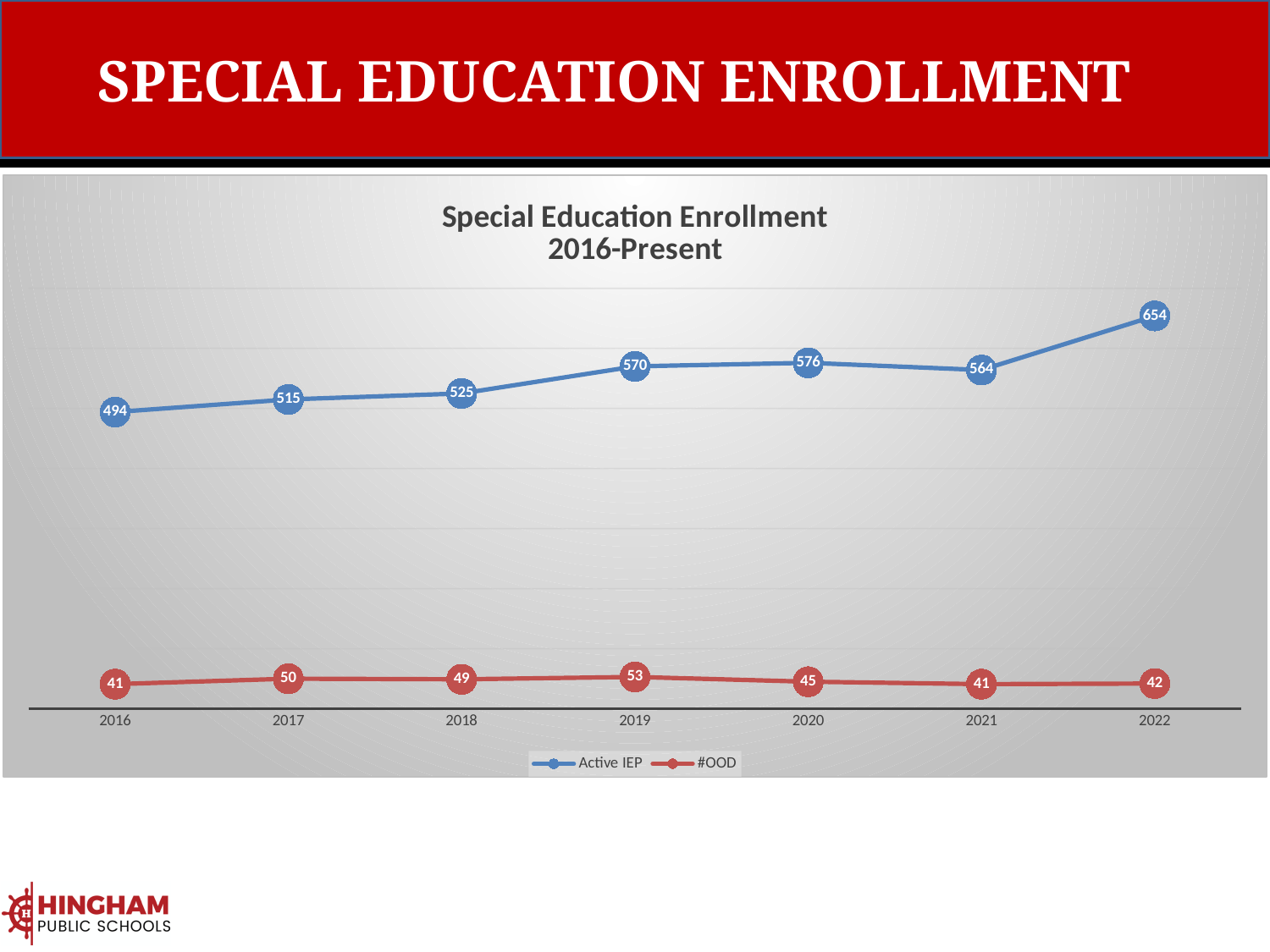
In which year is the Active IEP value highest? 2022 Which is larger, the Active IEP value for 2020 or for 2021? 2020 What is the Active IEP value for 2016? 494 Does the Active IEP series generally rise or fall from 2016 to 2022? rise What is the Active IEP value for 2022? 654 How many series does the legend list? 2 What kind of chart is shown on the slide? line chart How many years are plotted on the x axis? 7 In which year is the #OOD value highest? 2019 In which year is the Active IEP value lowest? 2016 What is the #OOD value for 2019? 53 What is the difference between the Active IEP values for 2022 and 2021? 90